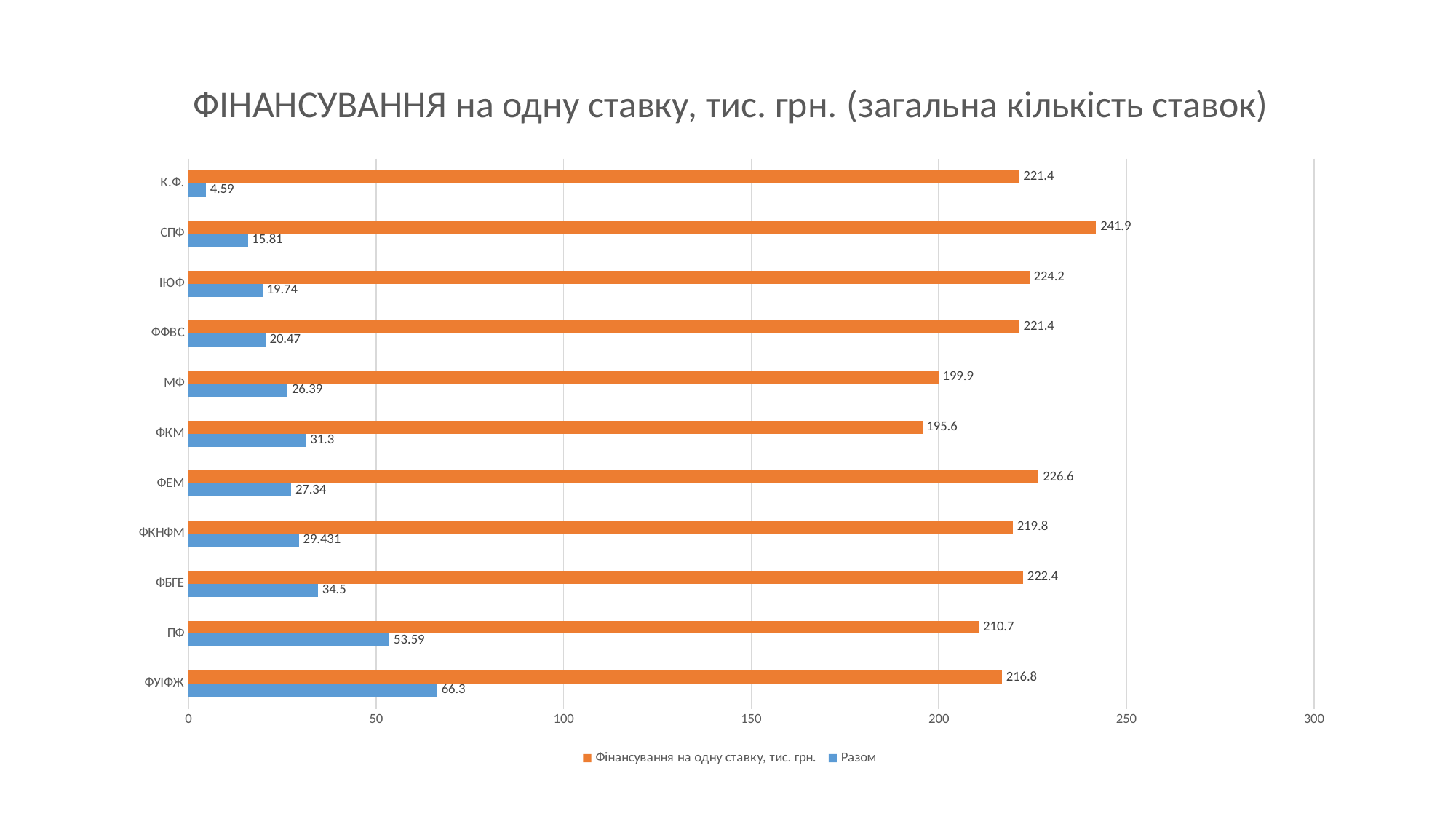
Which is larger, the "Фінансування на одну ставку, тис. грн." value for ФЕМ or for МФ? ФЕМ What type of chart is shown on the slide? Bar chart Which category has the lowest "Разом" value? К.Ф. What is the "Разом" value for ФУІФЖ? 66.3 What colour are the bars for the "Разом" series? Blue What is the difference between the "Разом" values for ПФ and ФБГЕ? 19.09 What is the value of "Фінансування на одну ставку, тис. грн." for СПФ? 241.9 Which category has the highest value for "Фінансування на одну ставку, тис. грн."? СПФ How many series does the legend list? 2 Which category has the lowest value for "Фінансування на одну ставку, тис. грн."? ФКМ How many categories are shown on the chart? 11 What is the "Разом" value for ФКНФМ? 29.431